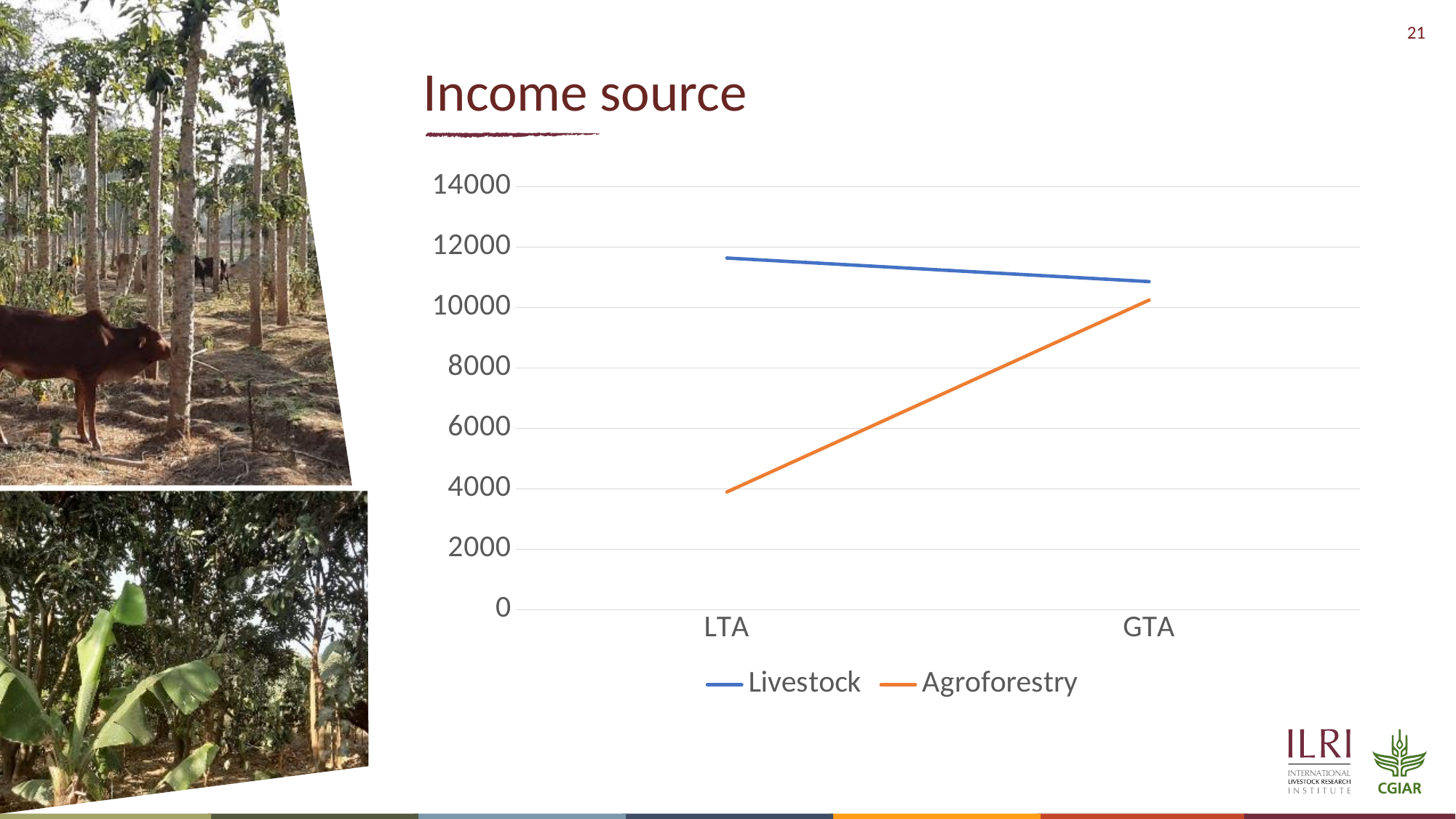
Does the Agroforestry line rise or fall from LTA to GTA? Rise Does the Livestock line rise or fall from LTA to GTA? Fall How many series does the legend list? 2 How many categories are shown on the x axis? 2 What is the title of the chart? Income source Is the Livestock value for LTA greater or less than 10000? greater Is the Agroforestry value for GTA greater or less than 8000? greater Is the Agroforestry value for LTA greater or less than 6000? less What kind of chart is shown on the slide? Line chart At LTA, which series has the larger value, Livestock or Agroforestry? Livestock Which colour is used for the Agroforestry line? Orange For the Agroforestry series, which category has the lower value? LTA